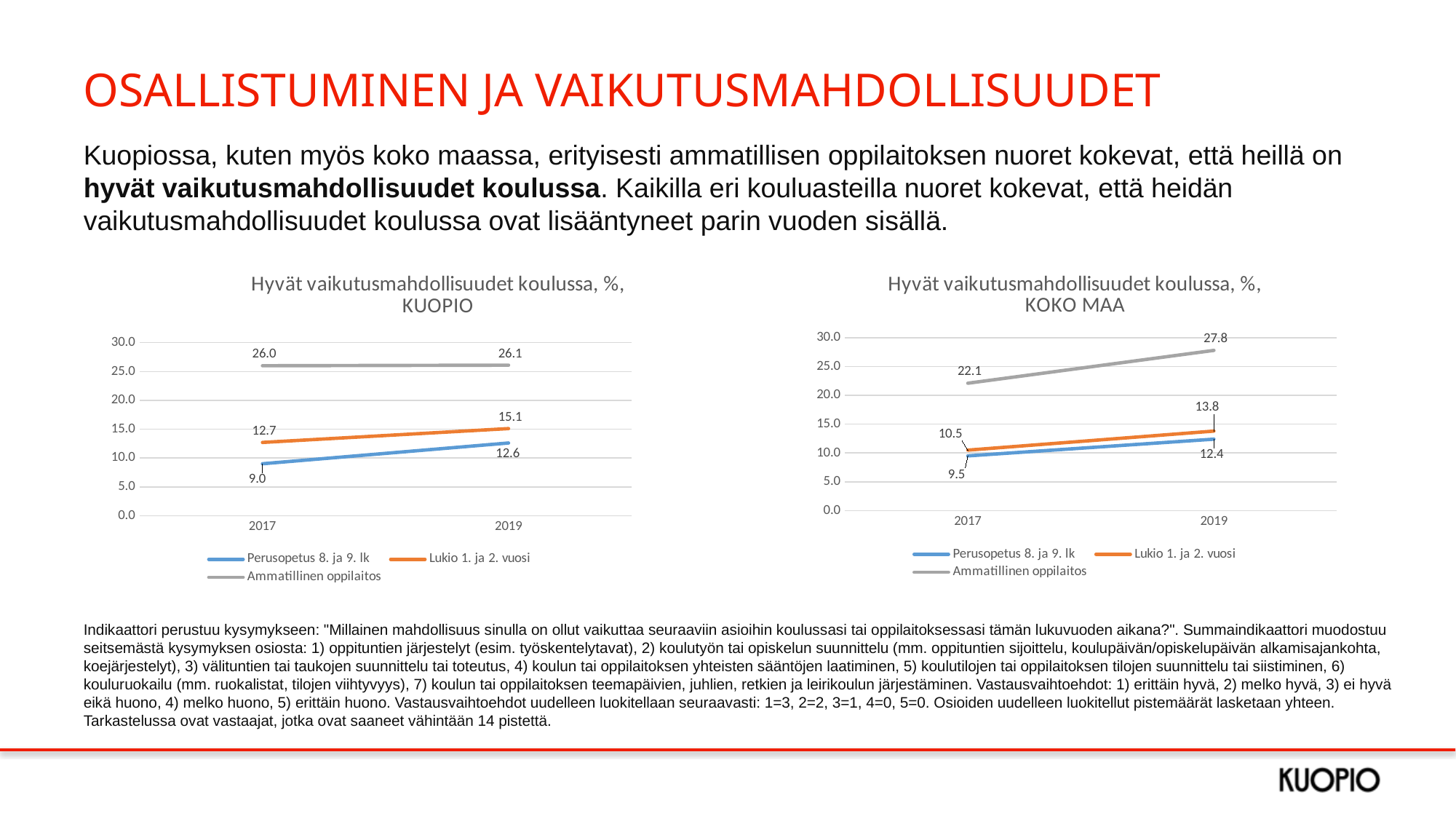
In the KOKO MAA chart, what is the value for Lukio 1. ja 2. vuosi in 2019? 13.8 In the KOKO MAA chart, what is the difference between the Ammatillinen oppilaitos values in 2019 and 2017? 5.7 In the KOKO MAA chart, what is the value for Ammatillinen oppilaitos in 2017? 22.1 How many series does the legend of the KUOPIO chart list? 3 In the KUOPIO chart, which series has the highest value in 2019? Ammatillinen oppilaitos In the KUOPIO chart, what is the difference between the Lukio 1. ja 2. vuosi values in 2019 and 2017? 2.4 Is the 2017 value for Perusopetus 8. ja 9. lk larger in the KUOPIO chart or in the KOKO MAA chart? KOKO MAA In the KOKO MAA chart, which series has the lowest value in 2017? Perusopetus 8. ja 9. lk In the KUOPIO chart, what is the value for Ammatillinen oppilaitos in 2017? 26.0 In the KOKO MAA chart, does the value for Ammatillinen oppilaitos rise or fall from 2017 to 2019? rise In the KUOPIO chart, what is the value for Perusopetus 8. ja 9. lk in 2019? 12.6 What kind of chart is the KOKO MAA chart? line chart